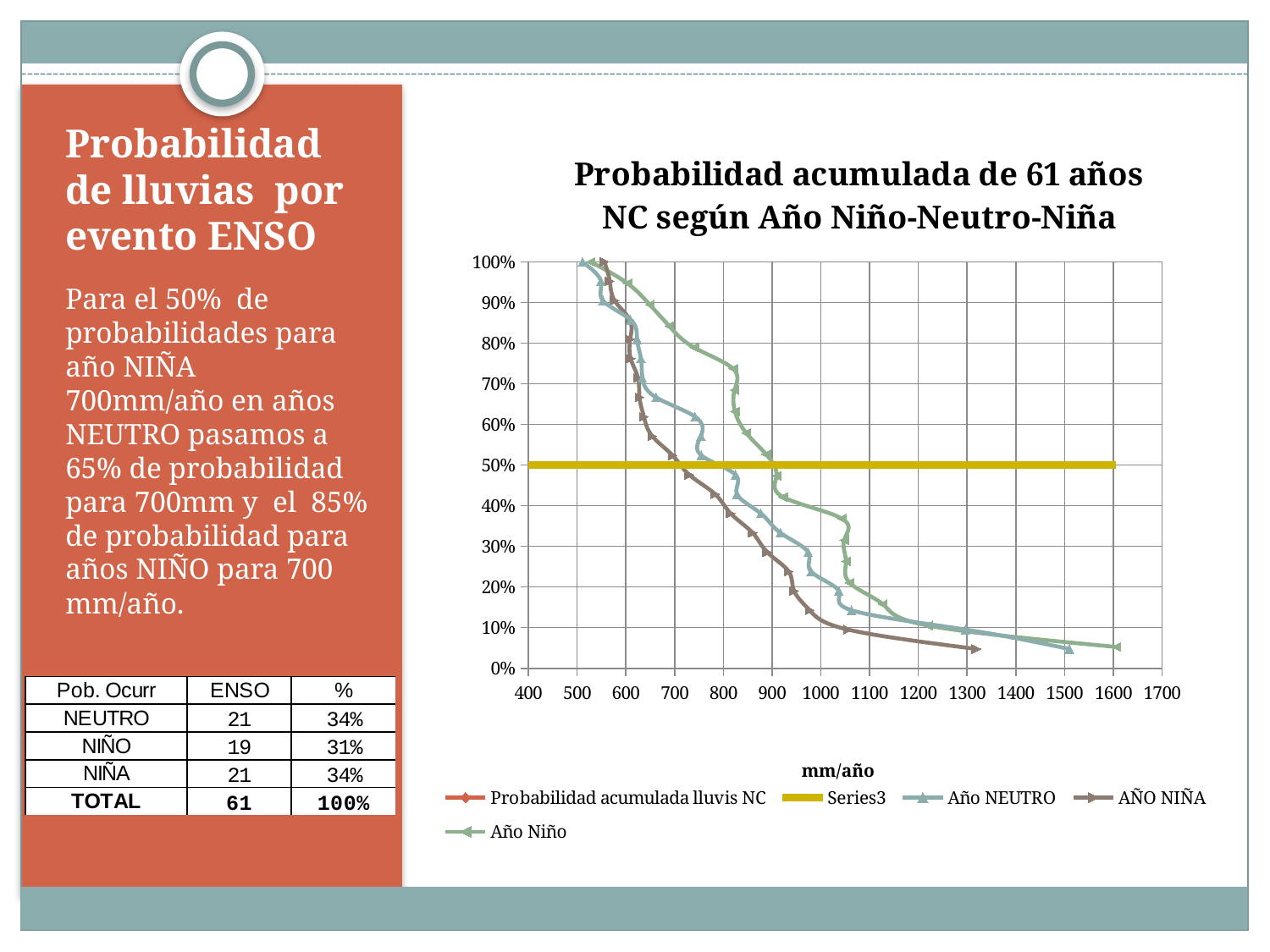
At 1000 mm/año, is the Año Niño curve greater or less than 30%? greater What is the label of the x axis of the chart? mm/año Which of the three ENSO curves extends to the highest mm/año value? Año Niño Is the value of the horizontal Series3 line greater or less than 60%? less Is the value of the horizontal Series3 line greater or less than 40%? greater Do the Año NEUTRO, AÑO NIÑA and Año Niño curves rise or fall as mm/año increases? Fall How many series does the chart legend list? 5 Which of the three ENSO curves ends at the lowest mm/año value? AÑO NIÑA At 900 mm/año, which curve is higher: Año Niño or AÑO NIÑA? Año Niño What is the title of the chart? Probabilidad acumulada de 61 años NC según Año Niño-Neutro-Niña What kind of chart is shown on the slide? Line chart